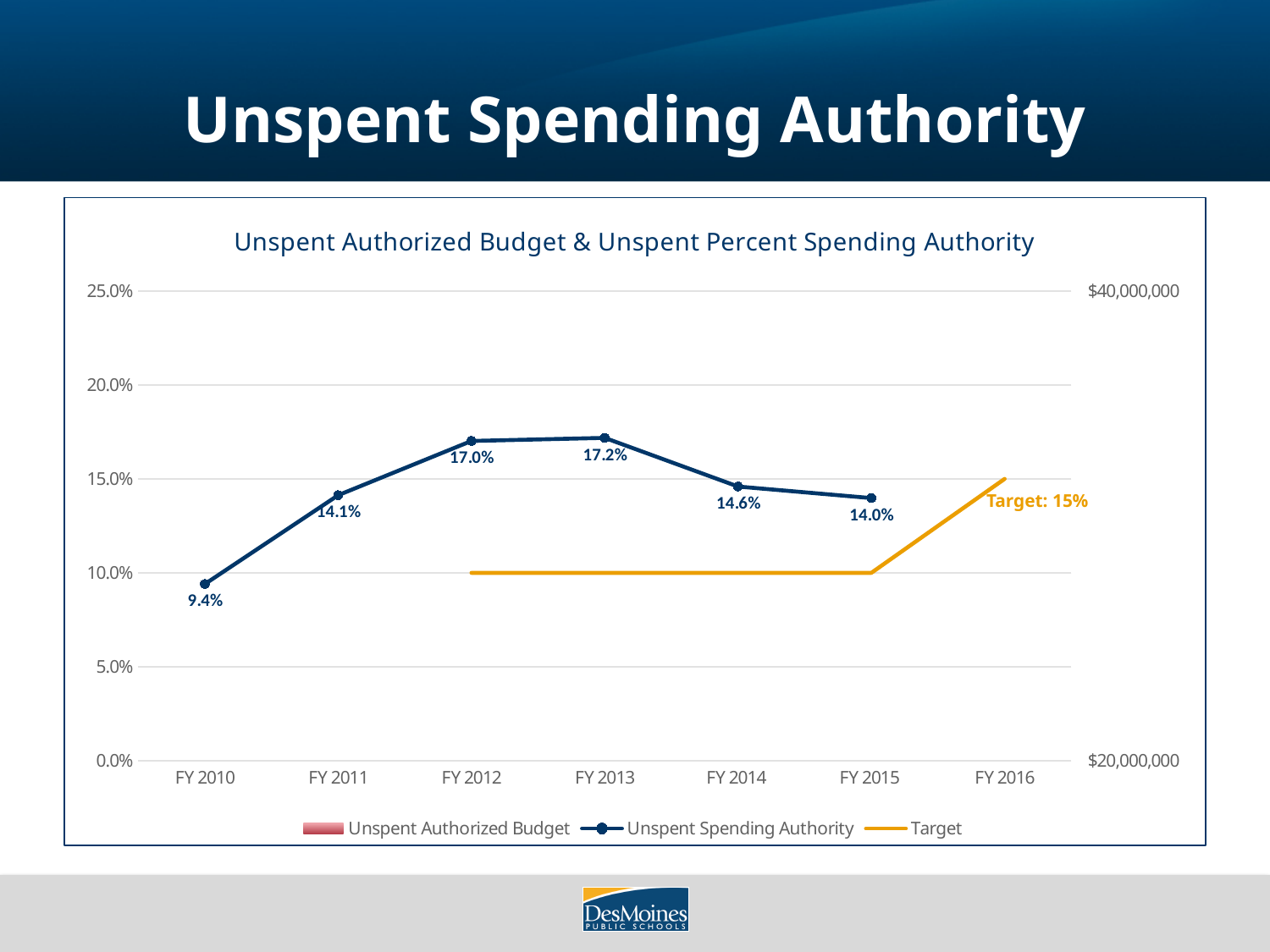
What is the Unspent Spending Authority value for FY 2010? 9.4% What kind of chart is used to show the Unspent Spending Authority? Line chart In which fiscal year is the Unspent Spending Authority lowest? FY 2010 Is the Unspent Spending Authority for FY 2012 greater or less than 15.0%? greater What target percentage is labelled on the Target line at FY 2016? 15% What is the Unspent Spending Authority value for FY 2013? 17.2% In which fiscal year is the Unspent Spending Authority highest? FY 2013 What is the difference in Unspent Spending Authority between FY 2013 and FY 2010? 7.8 percentage points Which is larger, the Unspent Spending Authority for FY 2011 or for FY 2014? FY 2014 How many series does the legend list? 3 How many fiscal years are shown on the x axis? 7 What is the Unspent Spending Authority value for FY 2015? 14.0%